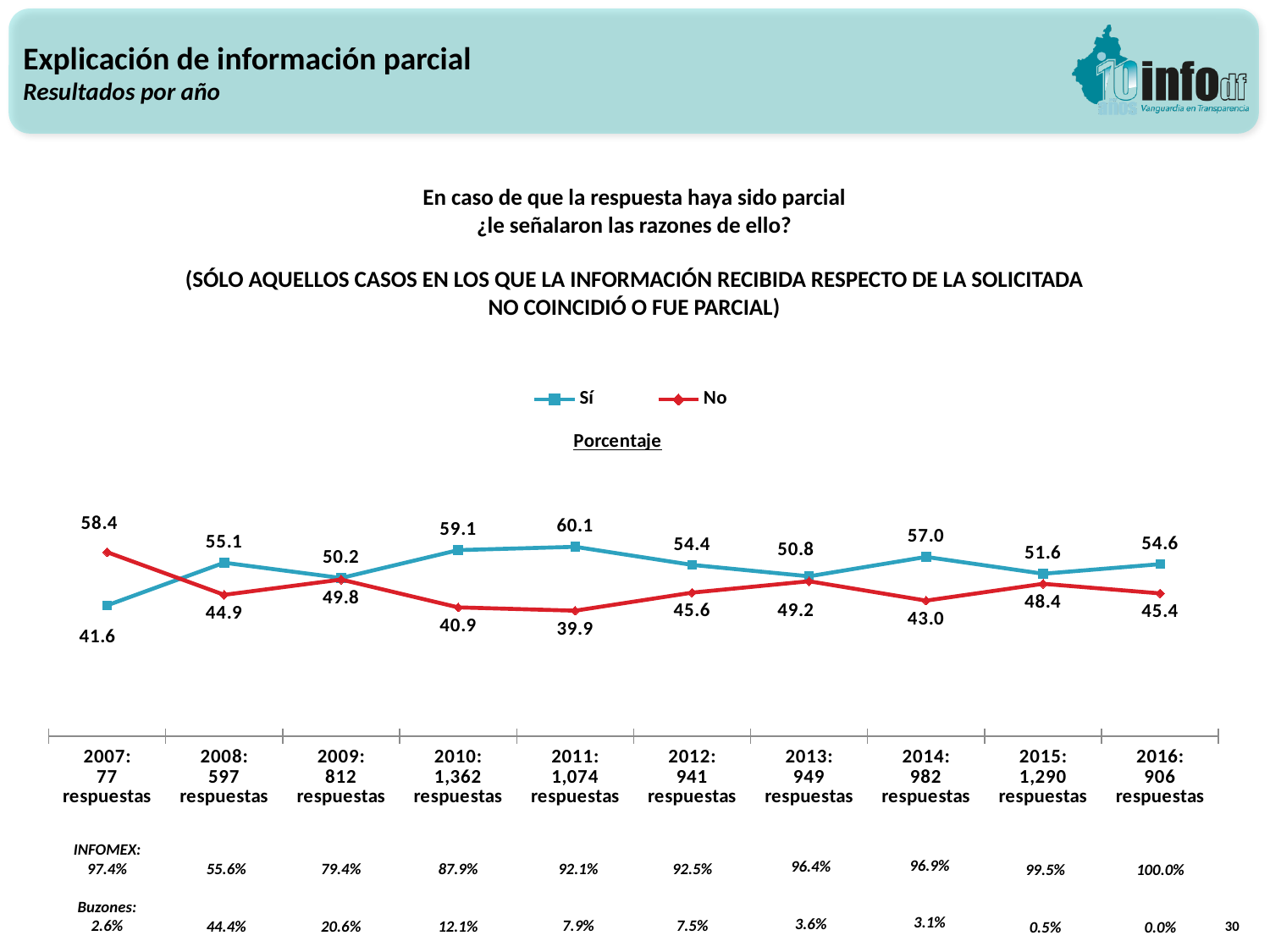
How many years are shown on the x axis of the chart? 10 Which series has the larger value in 2007, Sí or No? No In which year does the No series reach its lowest value? 2011 How many series does the legend list? 2 What is the value of the Sí series for 2011? 60.1 What kind of chart is shown on the slide? Line chart What is the value of the No series for 2007? 58.4 What is the value of the No series for 2014? 43.0 What is the difference between the Sí and No values in 2010? 18.2 Which colour is used for the No series? Red In which year does the Sí series reach its highest value? 2011 What is the value of the Sí series for 2016? 54.6